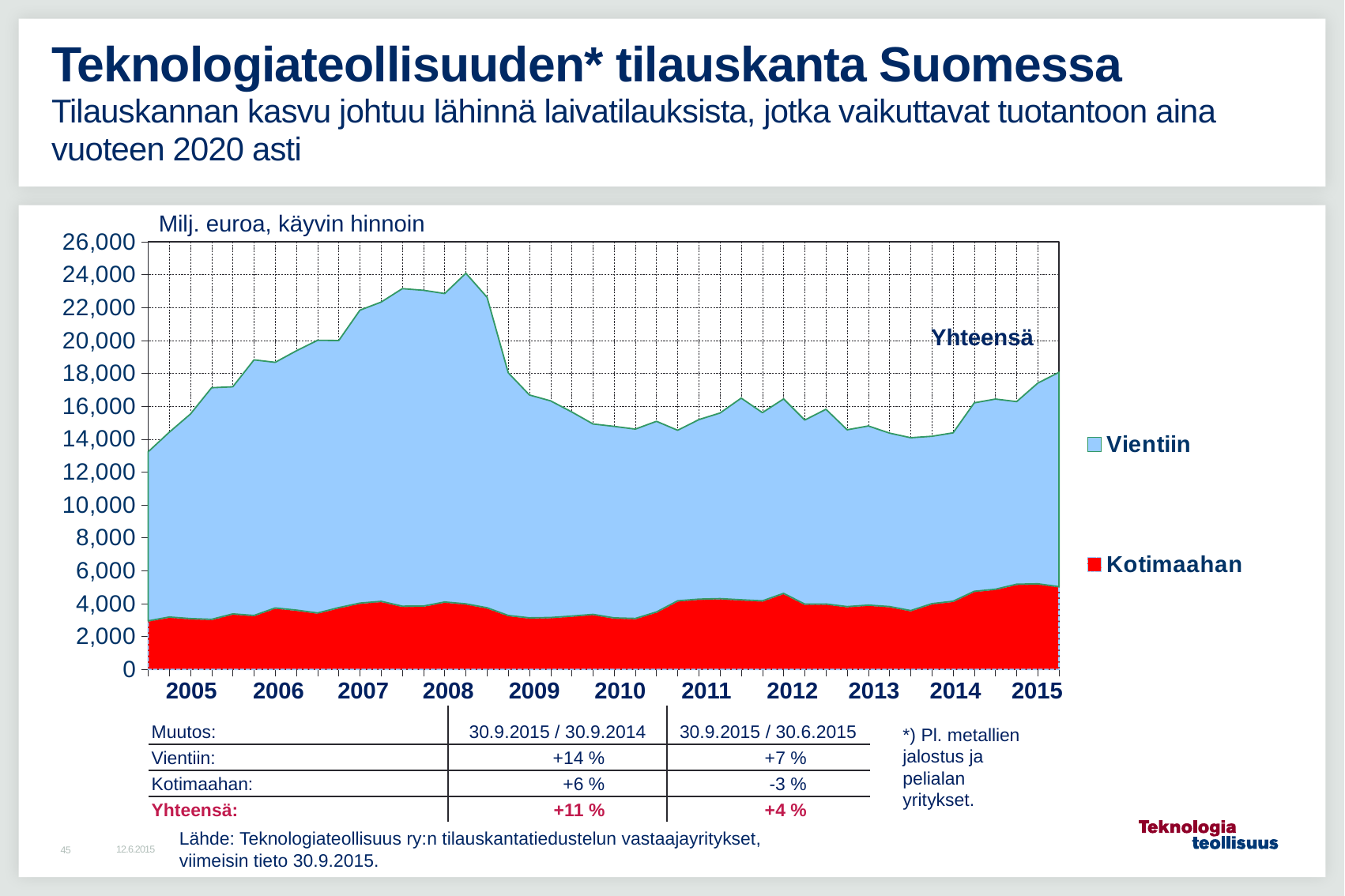
Is the Kotimaahan value at the start of 2005 greater or less than 4,000? less Which two series are listed in the chart legend? Vientiin and Kotimaahan Is the Kotimaahan value at the end of 2015 greater or less than 4,000? greater Does the total order backlog rise or fall between 2008 and 2009? Fall Which series is larger throughout the chart, Vientiin or Kotimaahan? Vientiin In which year does the total order backlog (Yhteensä) reach its highest point? 2008 Is the peak value of the total order backlog in 2008 greater or less than 22,000? greater What kind of chart is shown on the slide? Stacked area chart What unit is stated above the chart's y axis? Milj. euroa, käyvin hinnoin How many series does the chart legend list? 2 How many year labels are shown on the x axis of the chart? 11